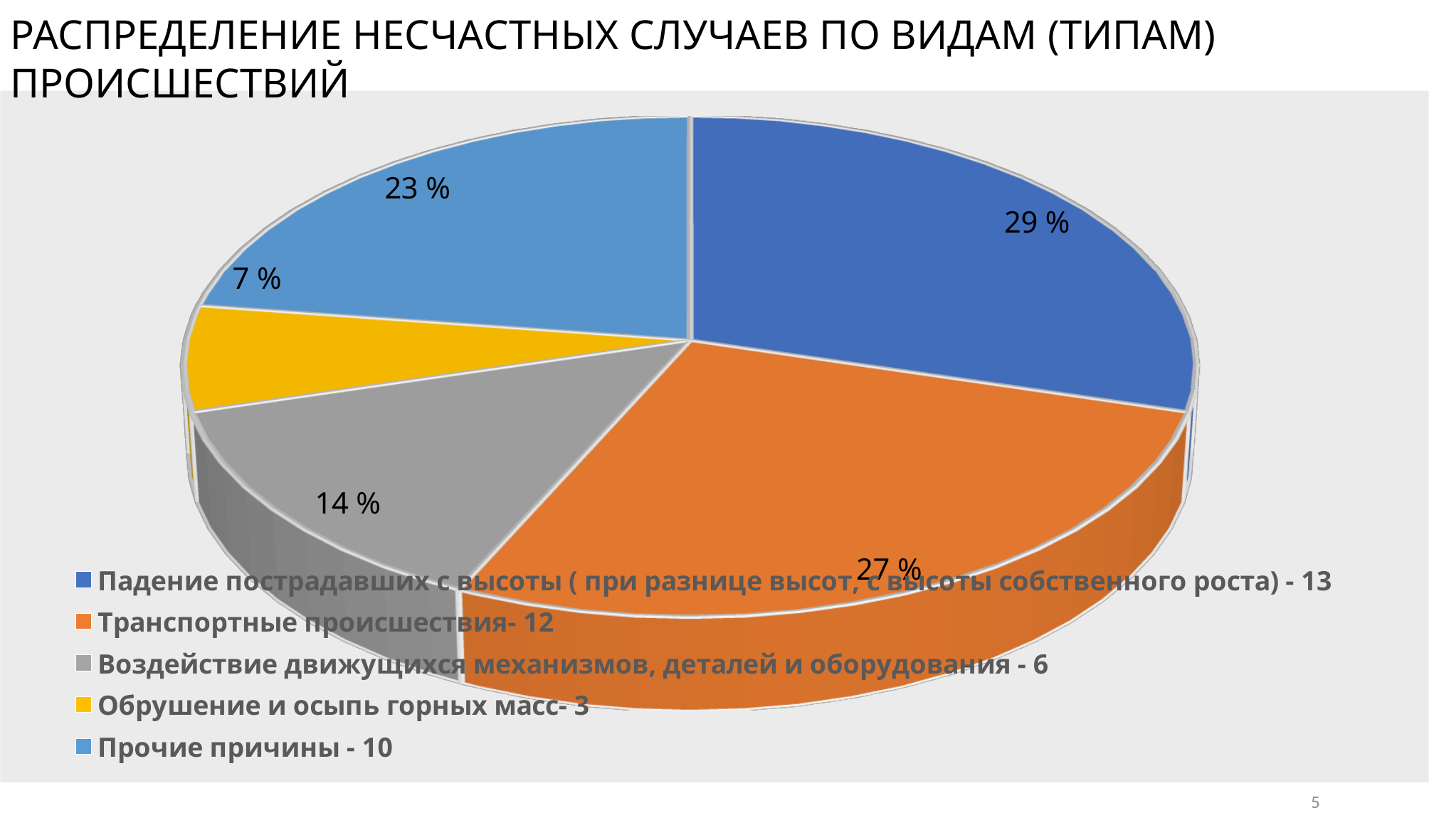
What percentage is shown for the slice "Транспортные происшествия"? 27 % What percentage is shown for the slice "Воздействие движущихся механизмов, деталей и оборудования"? 14 % What colour is the slice for "Обрушение и осыпь горных масс"? yellow Which category has the largest share of the pie? Падение пострадавших с высоты ( при разнице высот, с высоты собственного роста) Which slice is larger: "Транспортные происшествия" or "Воздействие движущихся механизмов, деталей и оборудования"? Транспортные происшествия What percentage is shown for the slice "Прочие причины"? 23 % What kind of chart is shown on the slide? pie chart How many slices does the pie chart have? 5 Which category has the smallest share of the pie? Обрушение и осыпь горных масс What percentage is shown for the slice "Обрушение и осыпь горных масс"? 7 % What is the difference in percentage points between the "Прочие причины" slice and the "Обрушение и осыпь горных масс" slice? 16 According to the legend, how many cases are listed for "Прочие причины"? 10